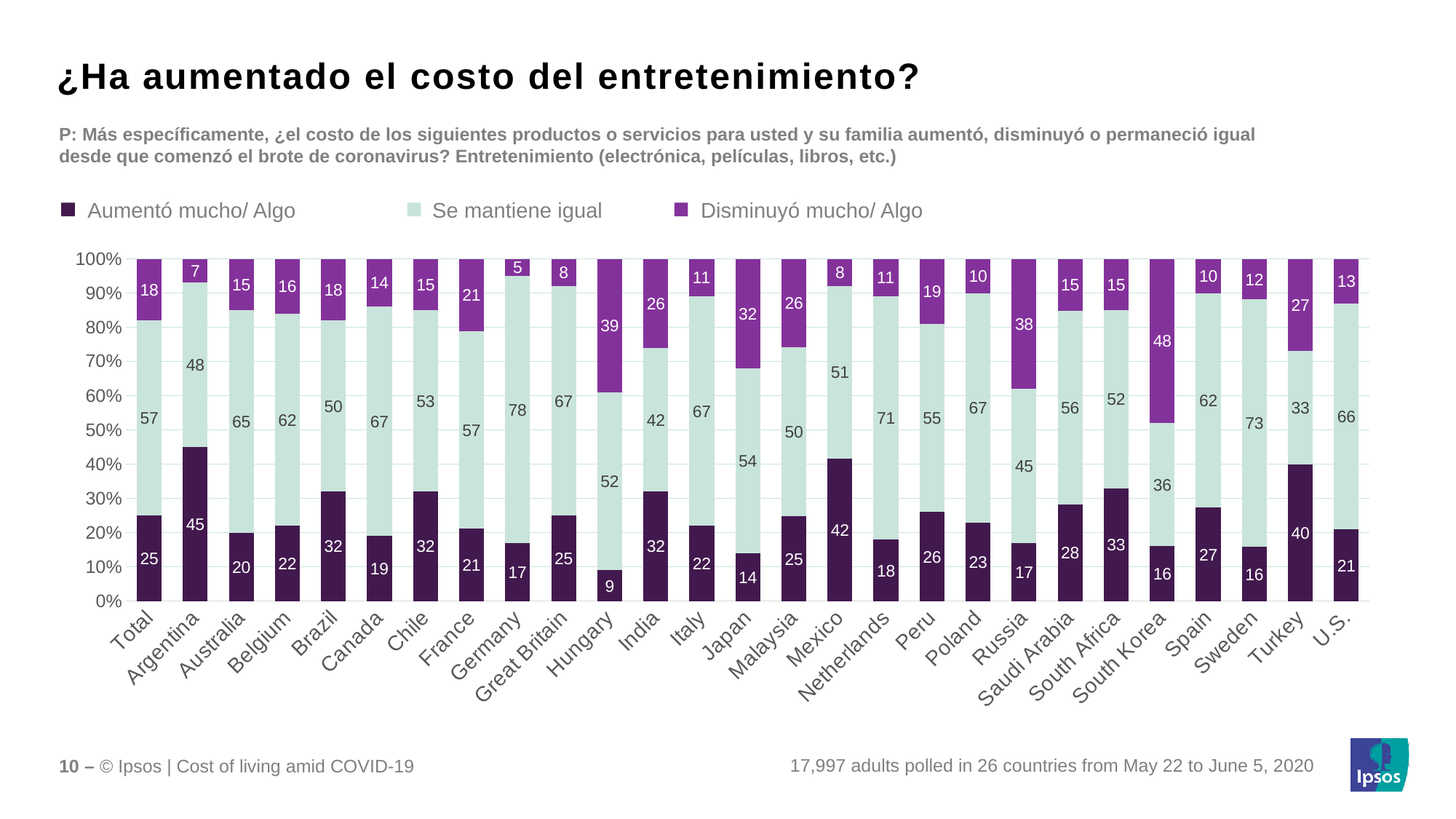
What is the value for 'Disminuyó mucho/ Algo' for South Korea? 48 Which country has the lowest value for 'Se mantiene igual'? Turkey How many countries/categories are shown on the x axis? 27 What is the value for 'Aumentó mucho/ Algo' for Argentina? 45 Which is larger: the 'Disminuyó mucho/ Algo' value for Hungary or for Russia? Hungary What is the difference between the 'Aumentó mucho/ Algo' values for Mexico and Total? 17 What is the value for 'Se mantiene igual' for Germany? 78 What kind of chart is shown on the slide? Stacked bar chart Which country has the highest value for 'Disminuyó mucho/ Algo'? South Korea How many series does the legend list? 3 Which country has the lowest value for 'Aumentó mucho/ Algo'? Hungary Which country has the highest value for 'Aumentó mucho/ Algo'? Argentina